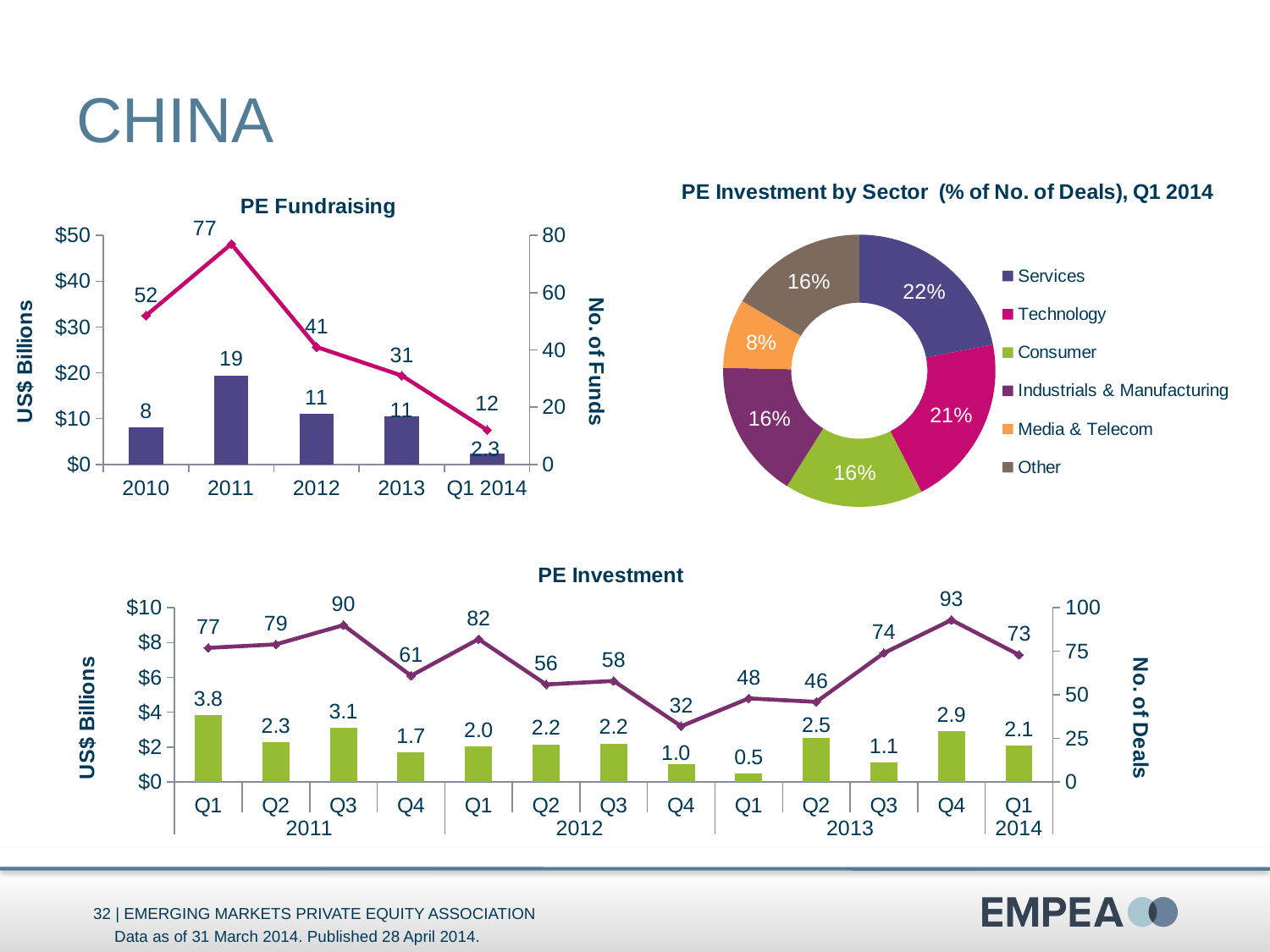
In the PE Investment chart, what was the investment value in US$ billions for Q1 2013? 0.5 In the PE Investment chart, which quarter had the highest number of deals? Q4 2013 In the PE Investment chart, which is larger: the investment value for Q1 2011 or Q3 2011? Q1 2011 What type of chart is the PE Investment by Sector chart? Donut (pie) chart In the PE Investment by Sector chart, which sector has the smallest share of deals? Media & Telecom How many sectors are listed in the legend of the PE Investment by Sector chart? 6 In the PE Fundraising chart, what was the fundraising value in US$ billions for 2011? 19 In the PE Fundraising chart, does the number of funds rise or fall from 2011 to Q1 2014? fall In the PE Fundraising chart, what is the difference in the number of funds between 2010 and 2013? 21 In the PE Fundraising chart, how many funds were raised in 2012? 41 In the PE Investment by Sector chart, what share of deals does Technology account for? 21% In the PE Fundraising chart, which year had the highest number of funds? 2011